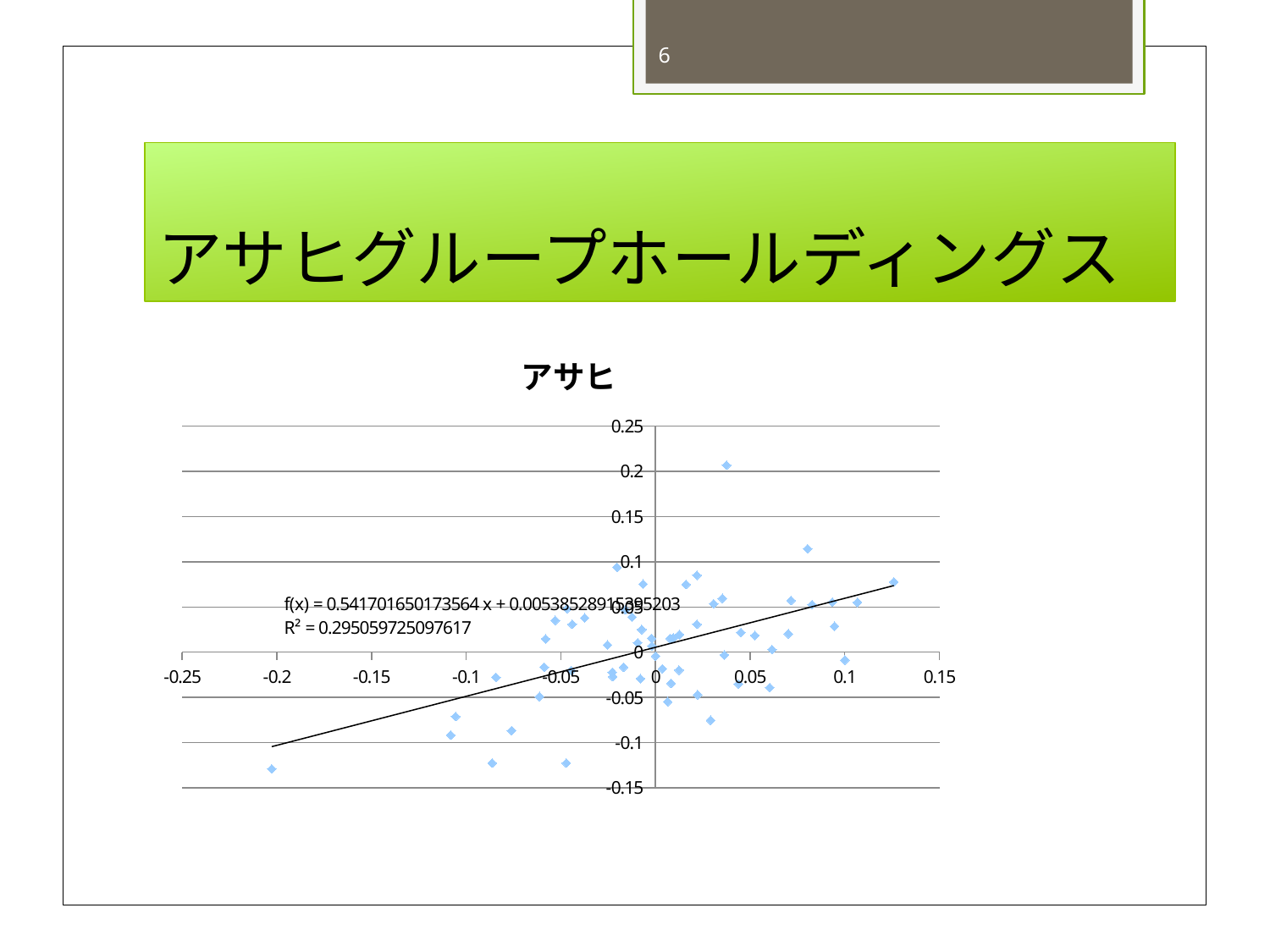
Is the y value of the lowest plotted point greater or less than -0.1? less What is the slope of the fitted line f(x) printed on the chart? 0.541701650173564 According to the trendline, do the y values rise or fall as x increases? rise Is the y value of the highest plotted point greater or less than 0.2? greater What is the R² value printed on the chart? 0.295059725097617 What is the intercept of the fitted line f(x) printed on the chart? 0.00538528915395203 Is the R² value of the trendline greater or less than 0.5? less What is the highest value shown on the y axis? 0.25 What kind of chart is shown on the slide? scatter chart What is the title of the chart? アサヒ What is the lowest value shown on the x axis? -0.25